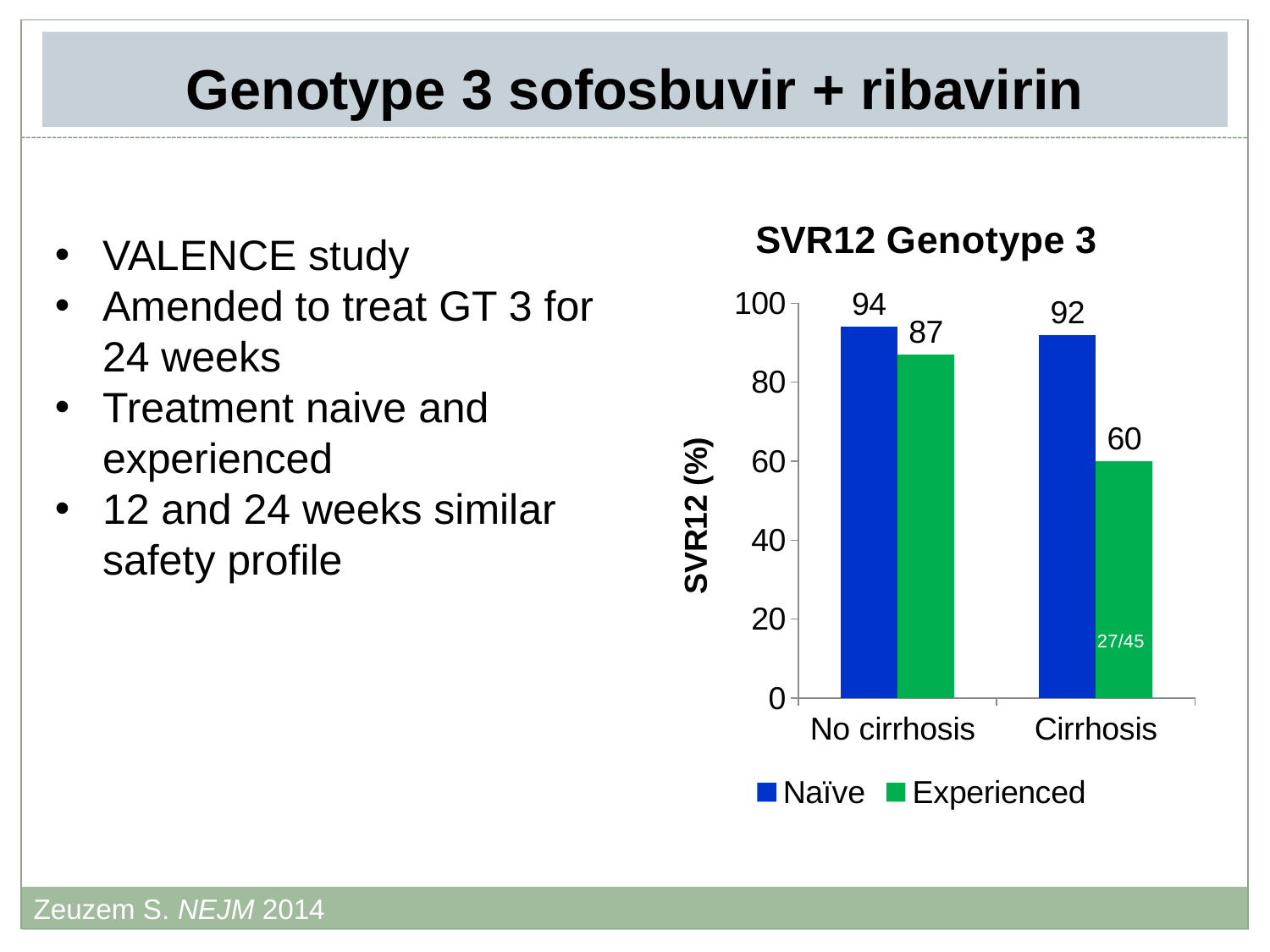
Which bar has the highest SVR12 value? Naïve, No cirrhosis Which bar has the lowest SVR12 value? Experienced, Cirrhosis What is the difference between the Naïve and Experienced SVR12 values in the Cirrhosis group? 32 What is the SVR12 value for Experienced patients with no cirrhosis? 87 What is the SVR12 value for Naïve patients with cirrhosis? 92 What is the SVR12 value for Experienced patients with cirrhosis? 60 Which is larger: the Experienced value for No cirrhosis or the Experienced value for Cirrhosis? No cirrhosis What is the title of the chart? SVR12 Genotype 3 What kind of chart is shown? Bar chart How many series does the legend list? 2 What is the SVR12 value for Naïve patients with no cirrhosis? 94 How many categories are shown on the x axis? 2